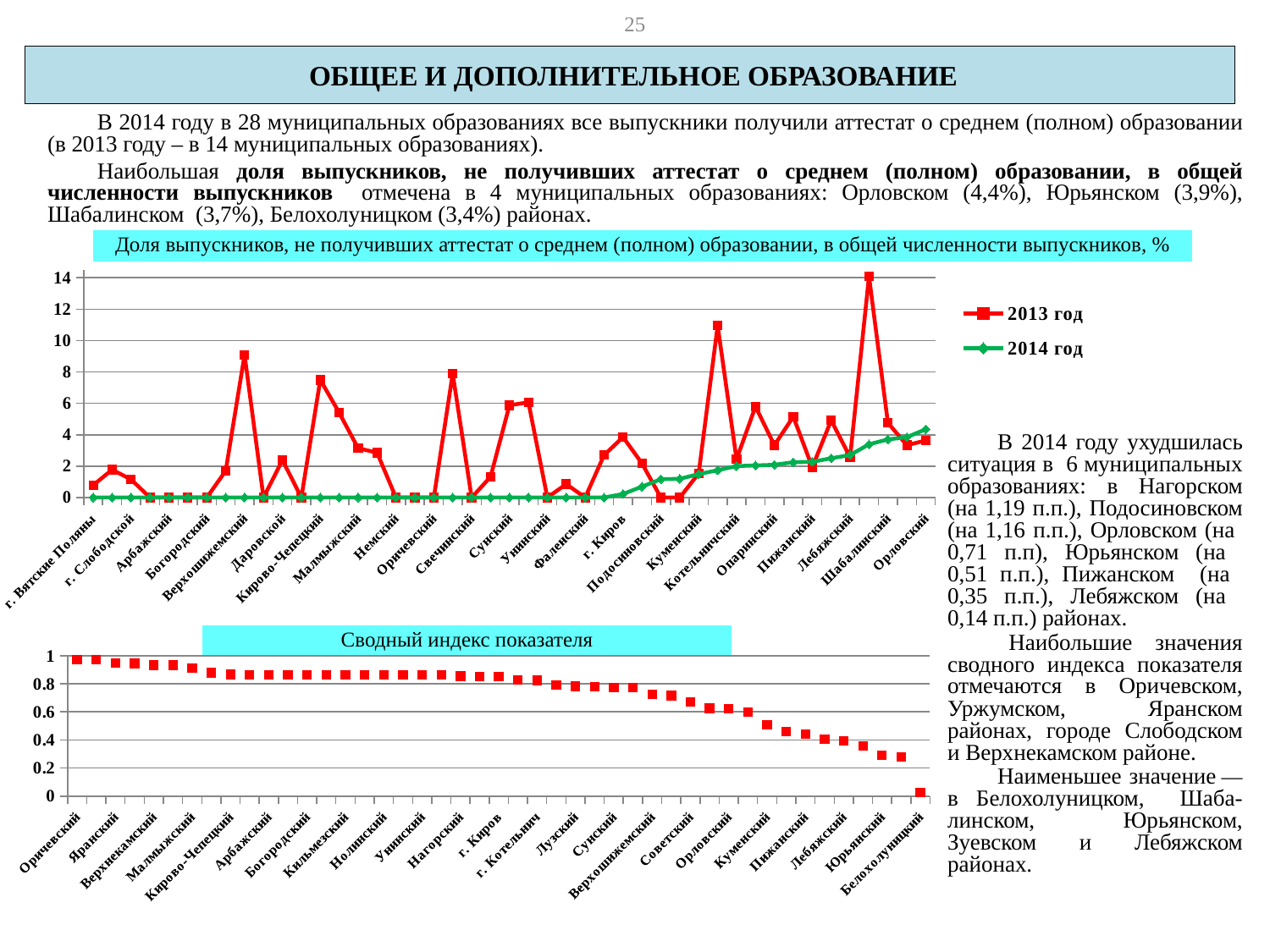
In the top chart, is the 2013 год value for Шабалинский greater or less than 12? less In the bottom chart (Сводный индекс показателя), which category has the lowest value? Белохолуницкий In the top chart, what is the 2014 год value for г. Вятские Поляны? 0 In the bottom chart (Сводный индекс показателя), which category has the highest value? Оричевский In the bottom chart (Сводный индекс показателя), is the value for Юрьянский greater or less than 0.4? less In the top chart, do the 2014 год values generally rise or fall from left to right along the x axis? rise In the top chart, is the 2013 год value for Котельничский greater or less than 10? less In the top chart (Доля выпускников, не получивших аттестат...), how many series does the legend list? 2 In the top chart, what are the two legend entries? 2013 год and 2014 год What kind of chart is the top chart (Доля выпускников, не получивших аттестат...)? line chart